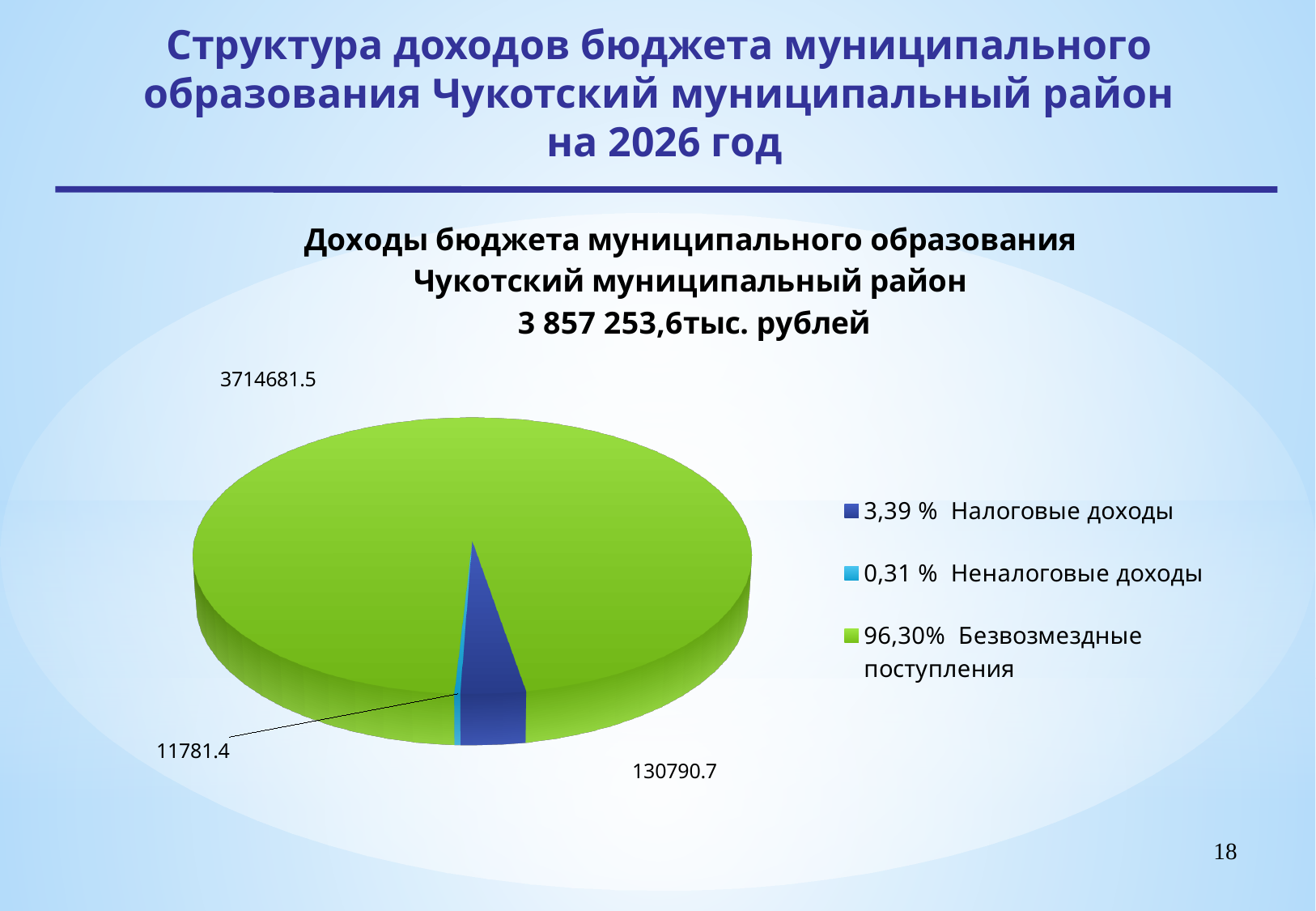
What is the value shown for Неналоговые доходы? 11781.4 How many slices does the pie chart have? 3 What is the value shown for Безвозмездные поступления? 3714681.5 What kind of chart is shown on the slide? pie chart What share of the pie does Налоговые доходы represent, according to the legend? 3,39 % Which category has the largest slice of the pie? Безвозмездные поступления What is the difference between the values for Налоговые доходы and Неналоговые доходы? 119009.3 Which category has the smallest slice of the pie? Неналоговые доходы What share of the pie does Безвозмездные поступления represent, according to the legend? 96,30% What is the value shown for Налоговые доходы? 130790.7 What total amount in thousand rubles is stated in the chart title? 3 857 253,6тыс. рублей Which is larger: the value for Налоговые доходы or the value for Неналоговые доходы? Налоговые доходы